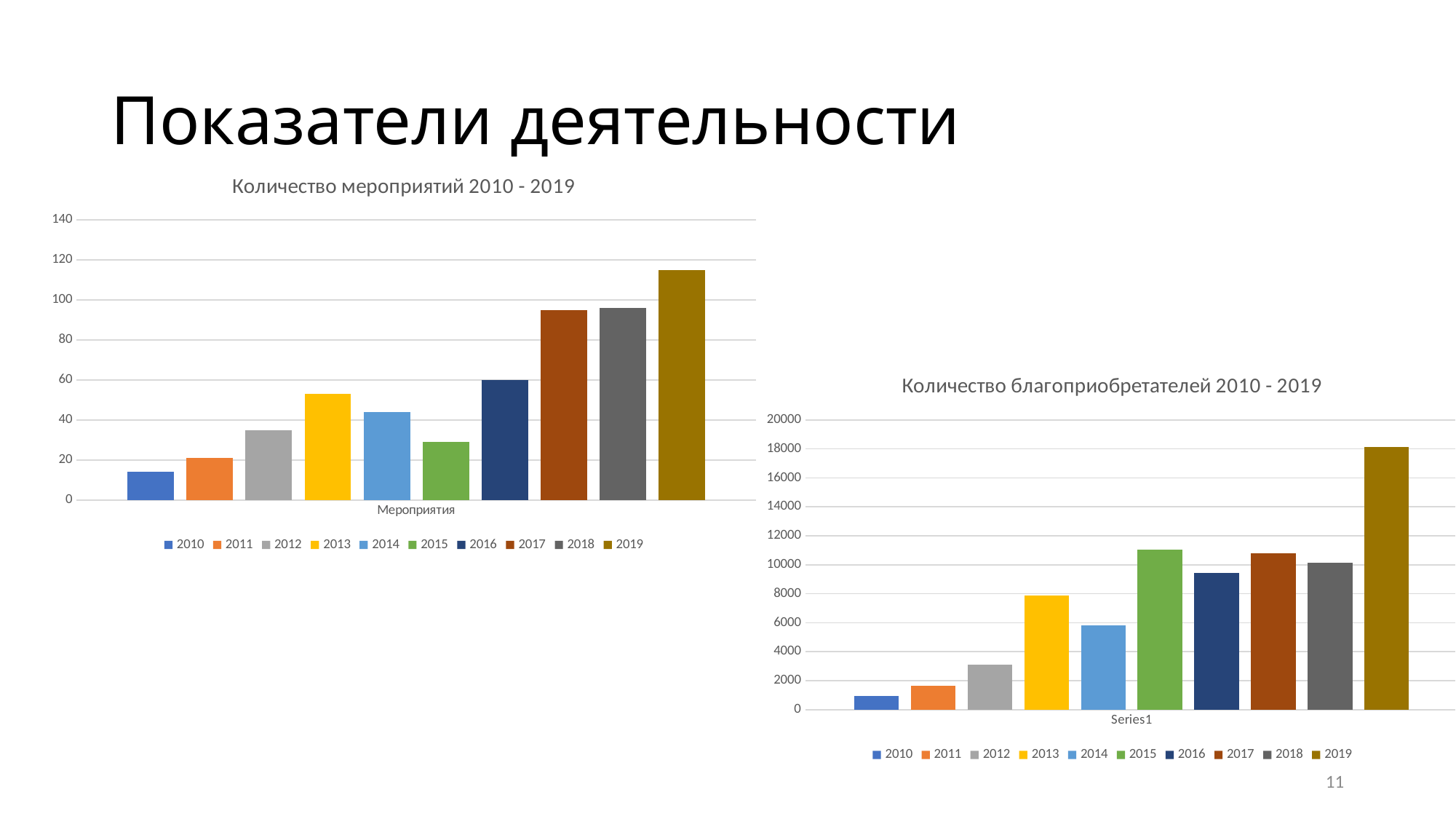
In the chart titled "Количество благоприобретателей 2010 - 2019", which is larger, the value for 2013 or the value for 2014? 2013 What kind of chart is the chart titled "Количество благоприобретателей 2010 - 2019"? bar chart How many entries does the legend of the chart titled "Количество мероприятий 2010 - 2019" list? 10 In the chart titled "Количество благоприобретателей 2010 - 2019", which year has the lowest bar? 2010 In the chart titled "Количество мероприятий 2010 - 2019", is the value for 2019 greater or less than 100? greater In the chart titled "Количество благоприобретателей 2010 - 2019", which year has the highest bar? 2019 In the chart titled "Количество мероприятий 2010 - 2019", which year has the highest bar? 2019 In the chart titled "Количество мероприятий 2010 - 2019", which year has the lowest bar? 2010 In the chart titled "Количество мероприятий 2010 - 2019", which is larger, the value for 2013 or the value for 2014? 2013 What is the category label shown on the x axis of the chart titled "Количество благоприобретателей 2010 - 2019"? Series1 In the chart titled "Количество мероприятий 2010 - 2019", is the value for 2015 greater or less than 40? less In the chart titled "Количество благоприобретателей 2010 - 2019", is the value for 2019 greater or less than 16000? greater